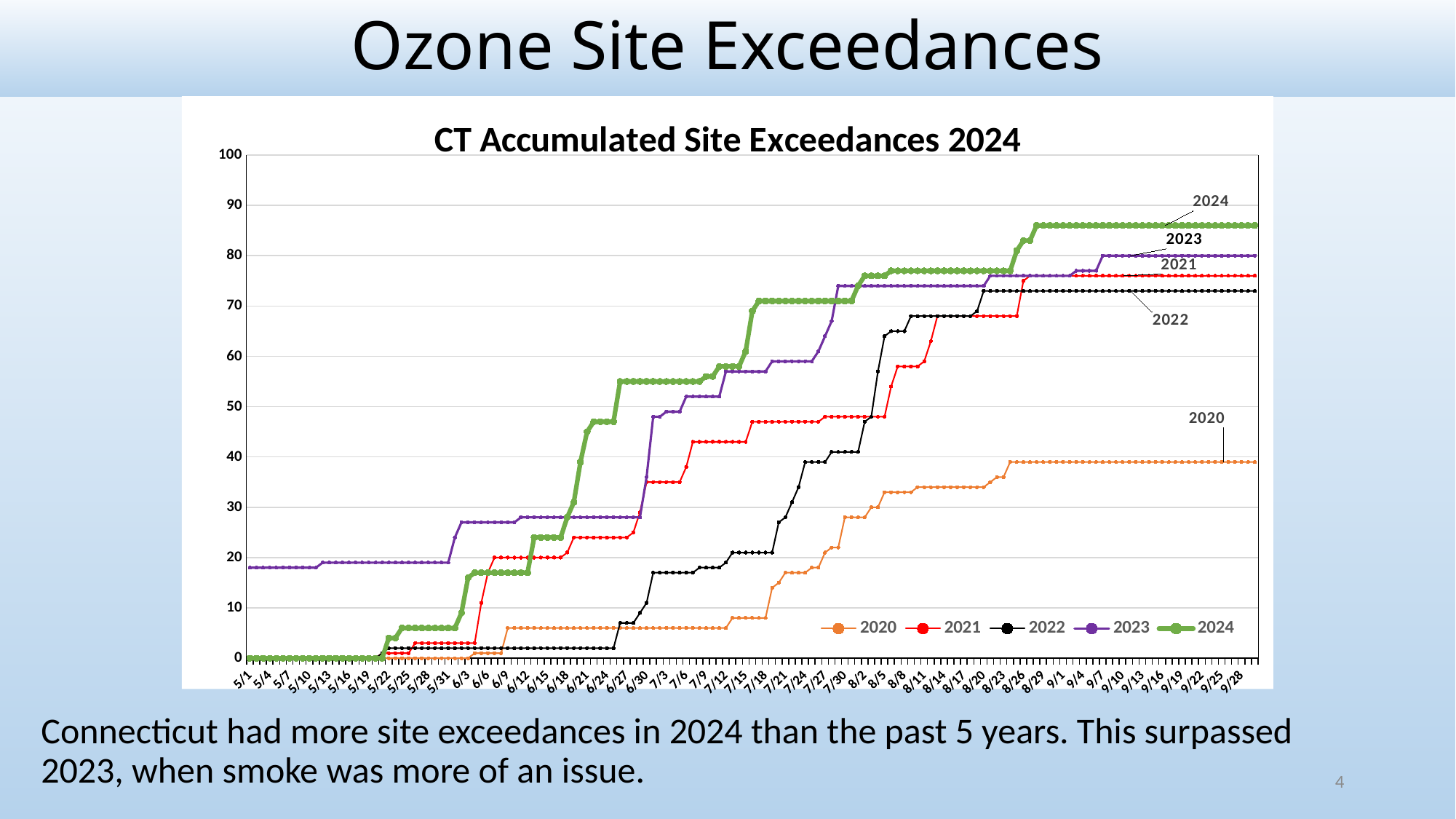
Do the values for each year rise or fall along the x axis? rise What kind of chart is shown on the slide? line chart How many series does the legend list? 5 Is the final value for 2024 greater or less than 80? greater Which year's line is highest at the end of the chart (late September)? 2024 At the end of the chart, which is larger: the value for 2020 or the value for 2022? 2022 Is the final value for 2020 greater or less than 50? less At the end of the chart, which is larger: the value for 2023 or the value for 2021? 2023 Is the value for 2023 on 5/1 greater or less than 10? greater What is the title of the chart? CT Accumulated Site Exceedances 2024 Which year's line is lowest at the end of the chart (late September)? 2020